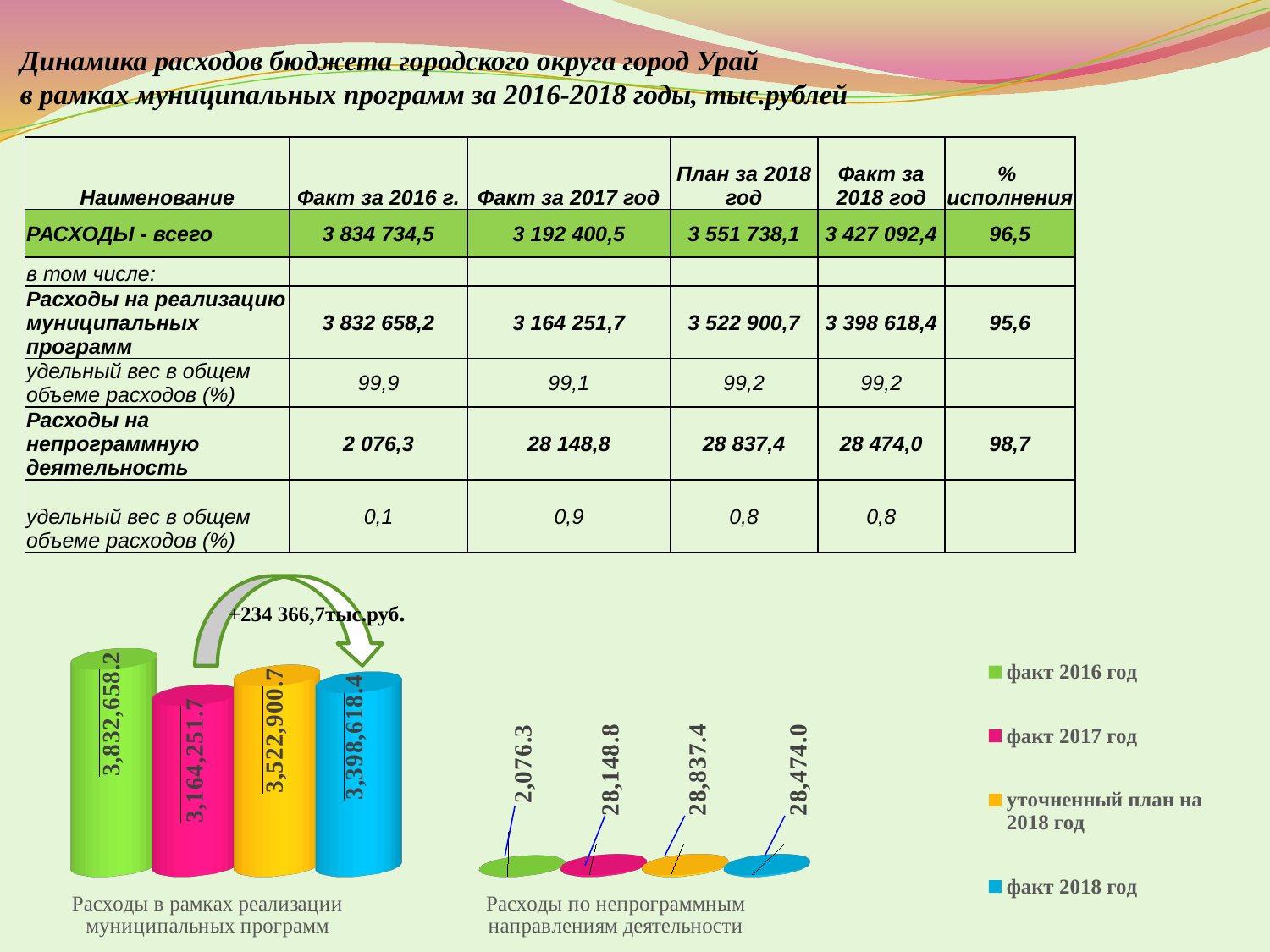
In the chart, which series has the highest value in the group 'Расходы в рамках реализации муниципальных программ'? факт 2016 год In the chart, what is the value for 'факт 2018 год' in the group 'Расходы по непрограммным направлениям деятельности'? 28,474.0 In the chart, which is larger in the group 'Расходы в рамках реализации муниципальных программ': 'уточненный план на 2018 год' or 'факт 2018 год'? уточненный план на 2018 год In the chart, what is the value for 'факт 2017 год' in the group 'Расходы в рамках реализации муниципальных программ'? 3,164,251.7 In the chart, what is the difference between 'уточненный план на 2018 год' and 'факт 2018 год' in the group 'Расходы в рамках реализации муниципальных программ'? 124,282.3 In the chart, what is the difference between 'факт 2017 год' and 'факт 2016 год' in the group 'Расходы по непрограммным направлениям деятельности'? 26,072.5 In the chart, which series has the lowest value in the group 'Расходы по непрограммным направлениям деятельности'? факт 2016 год In the chart, what is the value for 'уточненный план на 2018 год' in the group 'Расходы по непрограммным направлениям деятельности'? 28,837.4 What colour represents the series 'факт 2018 год' in the chart legend? blue What kind of chart is shown at the bottom of the slide? bar chart How many series does the chart legend list? 4 In the chart, what is the value for 'факт 2016 год' in the group 'Расходы в рамках реализации муниципальных программ'? 3,832,658.2